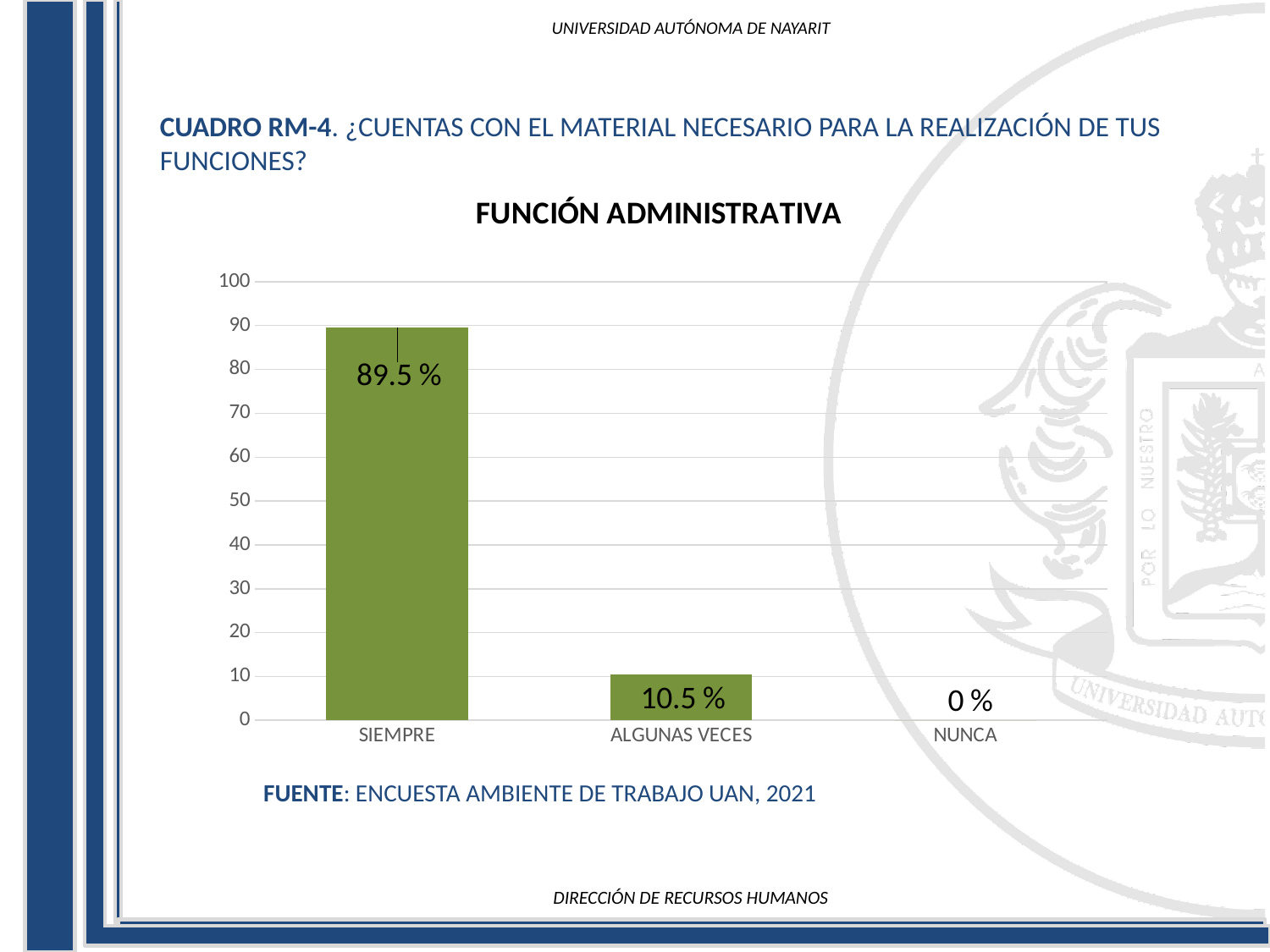
What is the value for SIEMPRE? 89.5 % What is the value for NUNCA? 0 % What kind of chart is shown? bar chart Is the value for SIEMPRE greater or less than 80? greater What is the title of the chart? FUNCIÓN ADMINISTRATIVA What is the difference between the values for SIEMPRE and ALGUNAS VECES? 79 % Which category has the highest value? SIEMPRE What is the value for ALGUNAS VECES? 10.5 % Which category has the lowest value? NUNCA How many categories are shown on the x axis? 3 Do the values rise or fall from left to right along the x axis? fall Which is larger, the value for ALGUNAS VECES or the value for NUNCA? ALGUNAS VECES